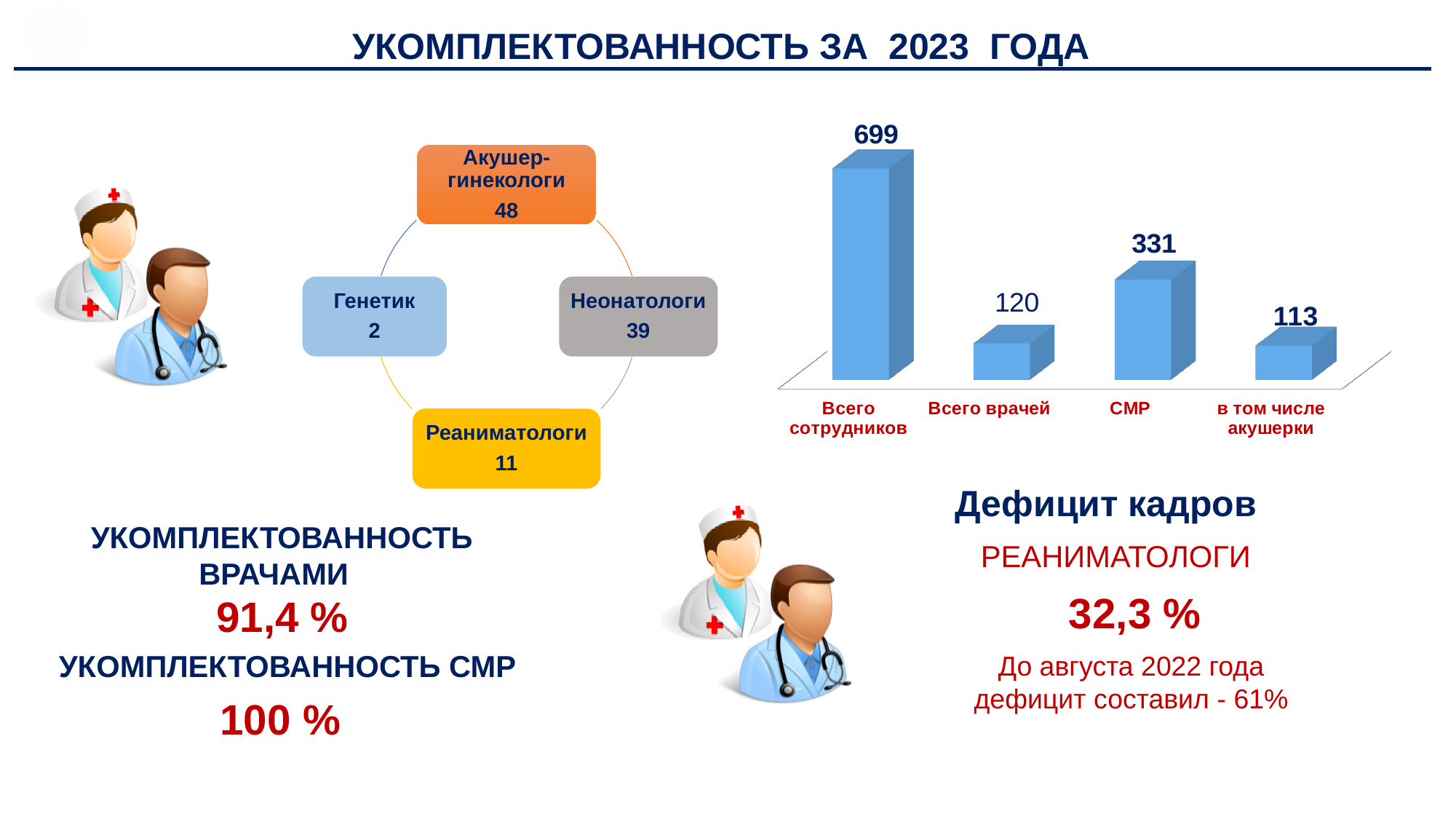
What kind of chart is shown on the right side of the slide? Bar chart What is the label of the first category on the x axis of the bar chart? Всего сотрудников What is the value for Всего сотрудников in the bar chart? 699 Which category has the highest value in the bar chart? Всего сотрудников Which category has the lowest value in the bar chart? в том числе акушерки What is the value for в том числе акушерки in the bar chart? 113 What is the value for СМР in the bar chart? 331 What is the difference between the values for Всего сотрудников and СМР in the bar chart? 368 What is the value for Всего врачей in the bar chart? 120 What is the difference between the values for СМР and Всего врачей in the bar chart? 211 How many categories are shown in the bar chart? 4 Which is larger in the bar chart: the value for Всего врачей or the value for СМР? СМР